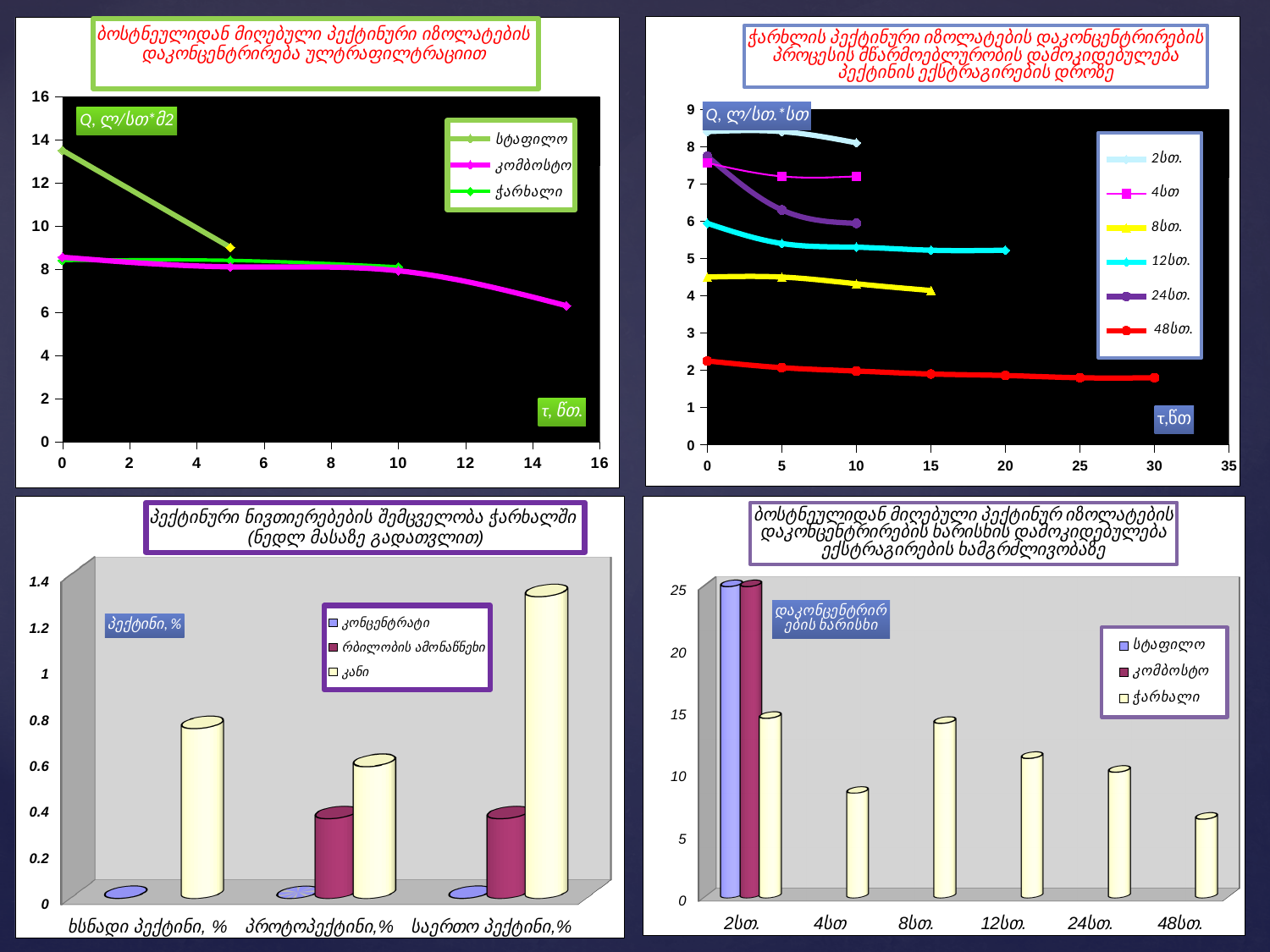
How many categories are shown on the x axis of the bottom-left chart? 3 In the bottom-right chart, is the ჭარხალი value for 48სთ. greater or less than 10? less What type of chart is the top-left chart (ბოსტნეულიდან მიღებული პექტინური იზოლატების დაკონცენტრირება ულტრაფილტრაციით)? line chart What type of chart is the bottom-left chart (პექტინური ნივთიერებების შემცველობა ჭარხალში)? bar chart In the top-left chart, does the სტაფილო series rise or fall along the x axis? fall In the top-left chart, is the value of კომპოსტო at τ = 15 greater or less than 8? less In the top-right chart, which series has the lowest values? 48სთ. How many series does the legend of the top-right chart (ჭარხლის პექტინური იზოლატების დაკონცენტრირების პროცესის მწარმოებლურობის დამოკიდებულება პექტინის ექსტრაგირების დროზე) list? 6 How many categories are shown on the x axis of the bottom-right chart (ბოსტნეულიდან მიღებული პექტინურ იზოლატების დაკონცენტრირების ხარისხის დამოკიდებულება ექსტრაგირების ხანგრძლივობაზე)? 6 How many series does the legend of the top-left chart list? 3 In the top-right chart, is the value of the 48სთ. series at τ = 0 greater or less than 3? less In the bottom-left chart, for the category პროტოპექტინი,%, which is larger: კანი or რბილობის ამონაწნეხი? კანი